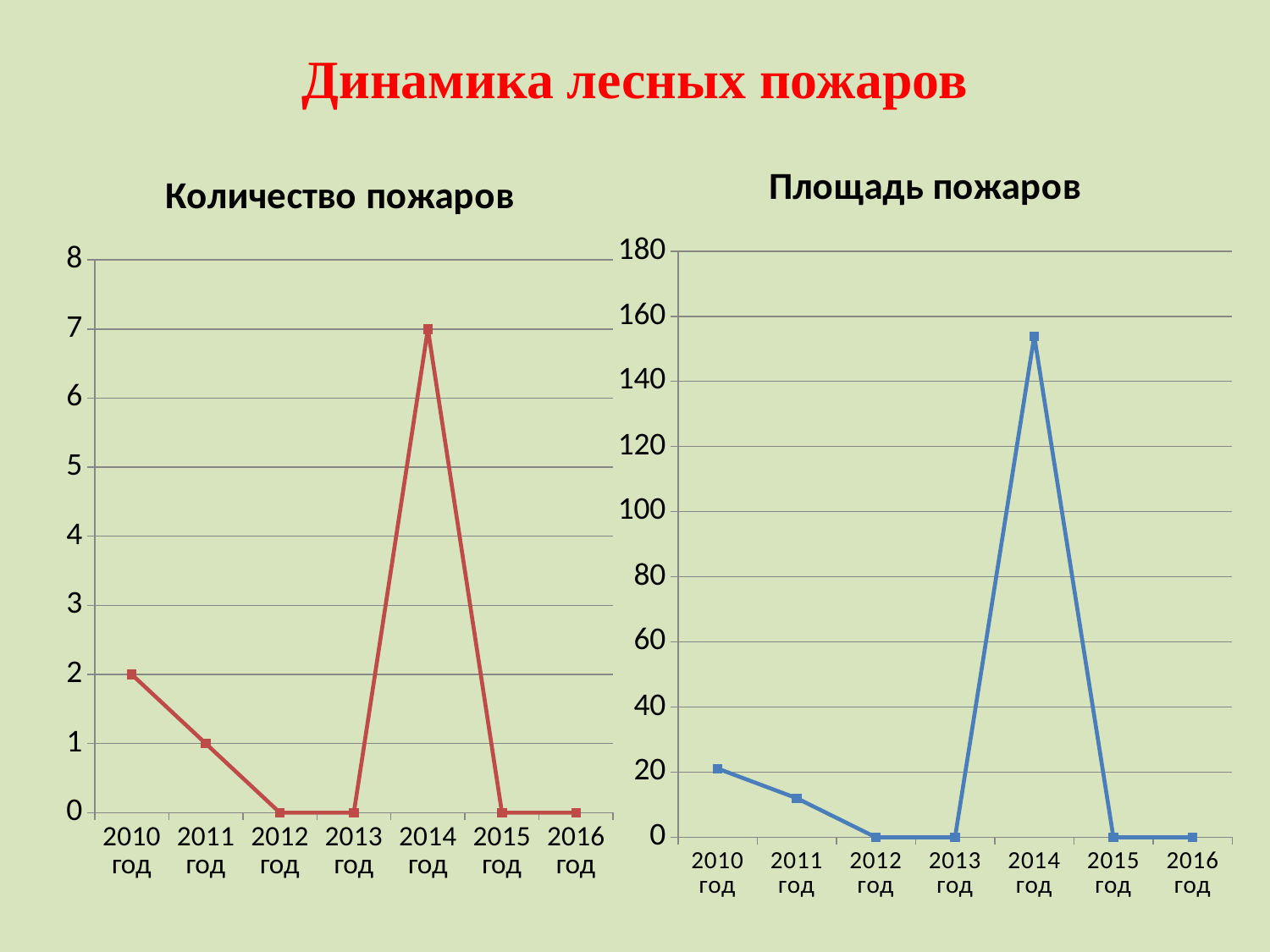
In the "Количество пожаров" chart, what is the value for 2011 год? 1 What is the title of the slide? Динамика лесных пожаров In the "Количество пожаров" chart, how many years are plotted on the x axis? 7 In the "Количество пожаров" chart, which year has the highest value? 2014 год In the "Площадь пожаров" chart, which year has the highest value? 2014 год In the "Количество пожаров" chart, what is the difference between the values for 2014 год and 2010 год? 5 In the "Площадь пожаров" chart, which is larger, the value for 2010 год or the value for 2011 год? 2010 год In the "Количество пожаров" chart, what is the value for 2010 год? 2 In the "Количество пожаров" chart, what is the value for 2014 год? 7 In the "Площадь пожаров" chart, is the value for 2011 год greater or less than 20? less In the "Площадь пожаров" chart, is the value for 2014 год greater or less than 140? greater What type of chart is the "Количество пожаров" chart? line chart